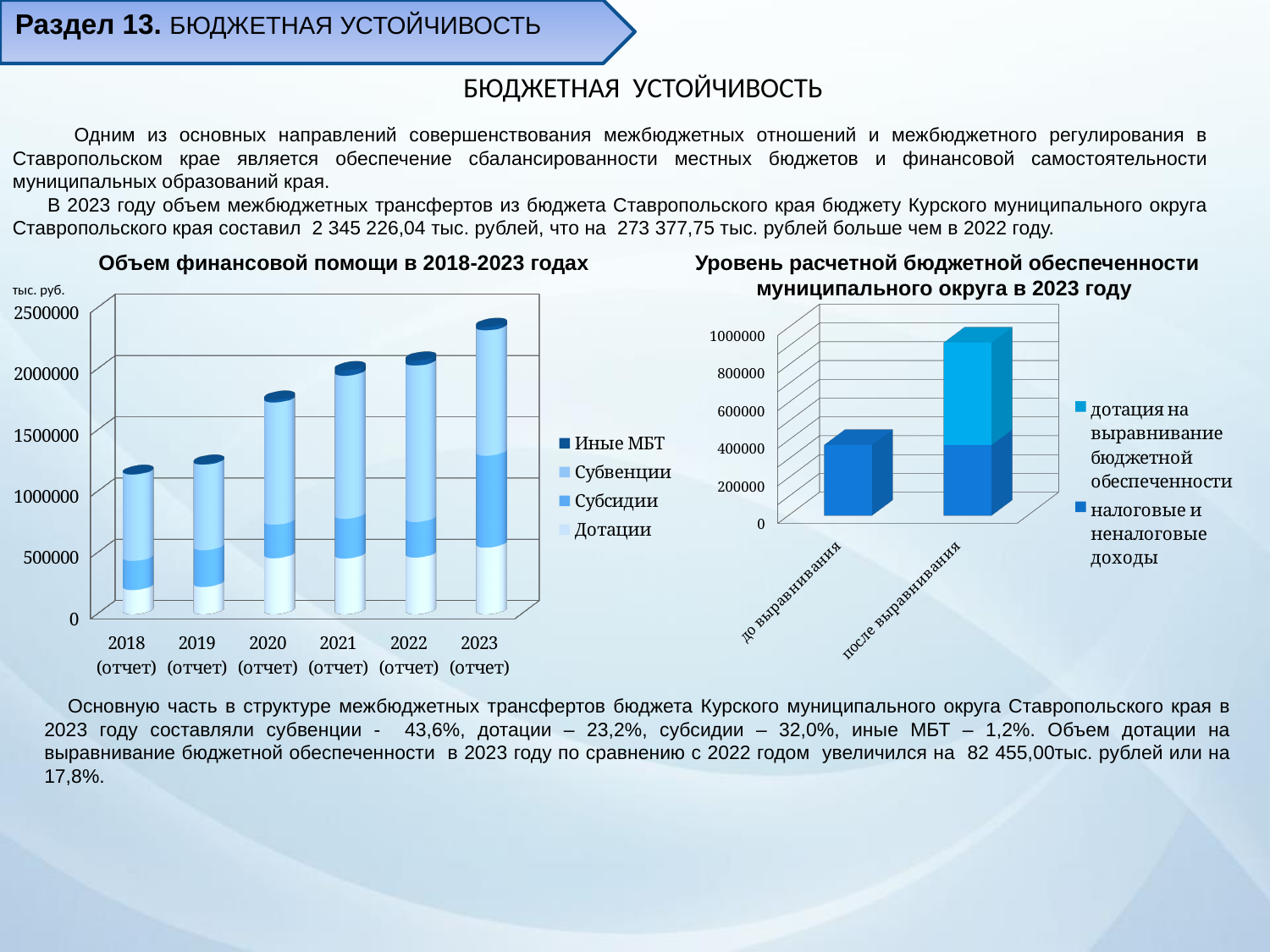
In the chart "Объем финансовой помощи в 2018-2023 годах", do the total bars generally rise or fall from 2018 to 2023? Rise In the chart "Объем финансовой помощи в 2018-2023 годах", how many years are shown on the x axis? 6 In the right chart "Уровень расчетной бюджетной обеспеченности муниципального округа в 2023 году", which category has the higher total bar? после выравнивания How many series does the legend of the chart "Объем финансовой помощи в 2018-2023 годах" list? 4 In the chart "Объем финансовой помощи в 2018-2023 годах", which is larger: the total bar for 2020 (отчет) or for 2022 (отчет)? 2022 (отчет) In the chart "Объем финансовой помощи в 2018-2023 годах", which year has the highest total bar? 2023 (отчет) What kind of chart is the left chart titled "Объем финансовой помощи в 2018-2023 годах"? Stacked bar chart In the chart "Объем финансовой помощи в 2018-2023 годах", is the total bar for 2023 (отчет) greater or less than 2000000? greater What unit is shown above the vertical axis of the chart "Объем финансовой помощи в 2018-2023 годах"? тыс. руб. In the right chart "Уровень расчетной бюджетной обеспеченности муниципального округа в 2023 году", is the total bar for "до выравнивания" greater or less than 600000? less In the chart "Объем финансовой помощи в 2018-2023 годах", is the total bar for 2018 (отчет) greater or less than 1500000? less How many series does the legend of the right chart "Уровень расчетной бюджетной обеспеченности муниципального округа в 2023 году" list? 2